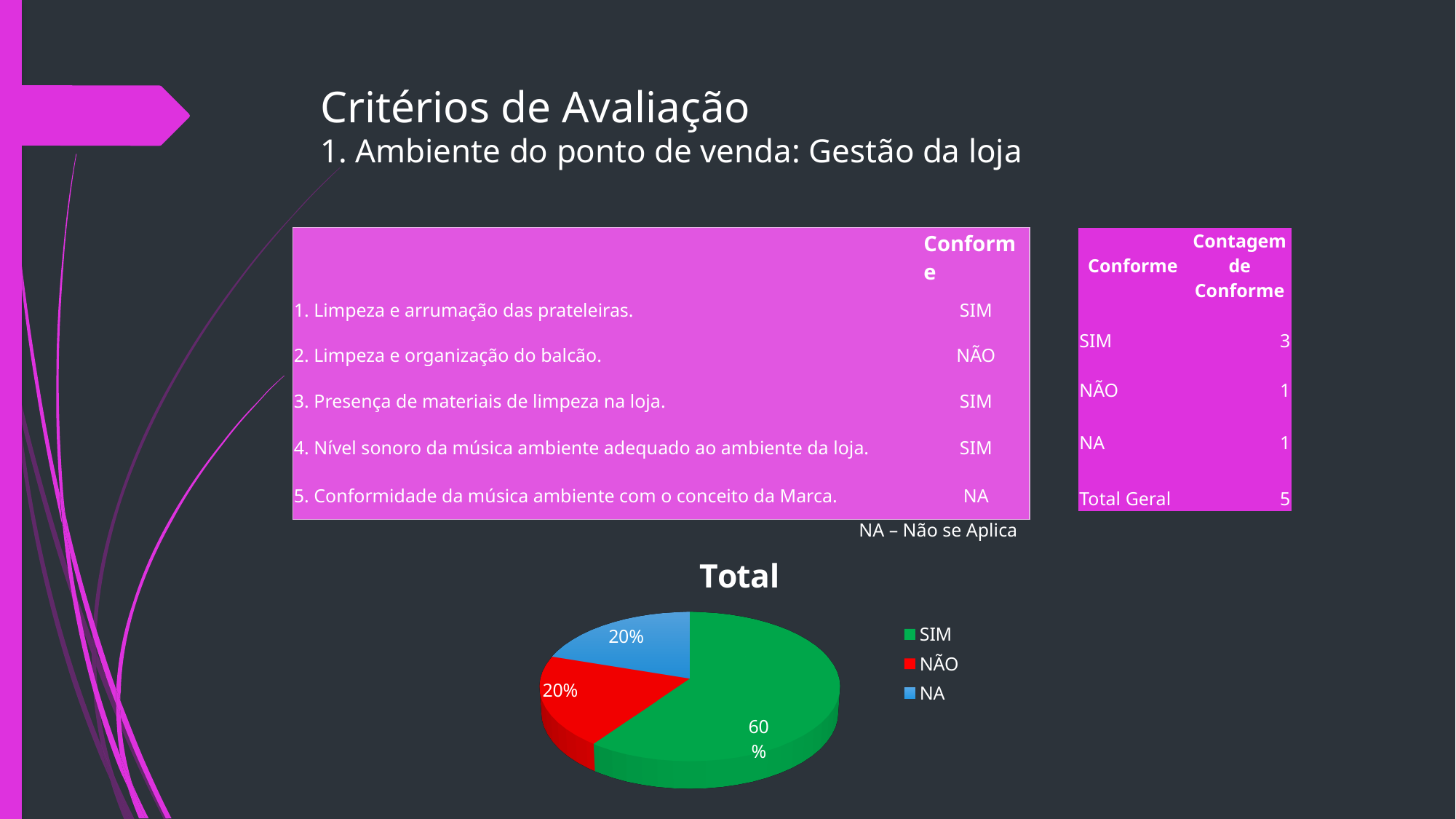
Is the share for SIM greater or less than 50%? greater What share of the pie does NA represent? 20% What is the difference in percentage points between the SIM slice and the NA slice? 40% What is the title of the chart? Total How many slices does the pie chart have? 3 What share of the pie does NÃO represent? 20% What colour is the SIM slice in the pie chart? green What kind of chart is shown on the slide? pie chart How many entries does the legend list? 3 Which category has the largest slice of the pie? SIM Which is larger, the slice for SIM or the slice for NÃO? SIM What share of the pie does SIM represent? 60%